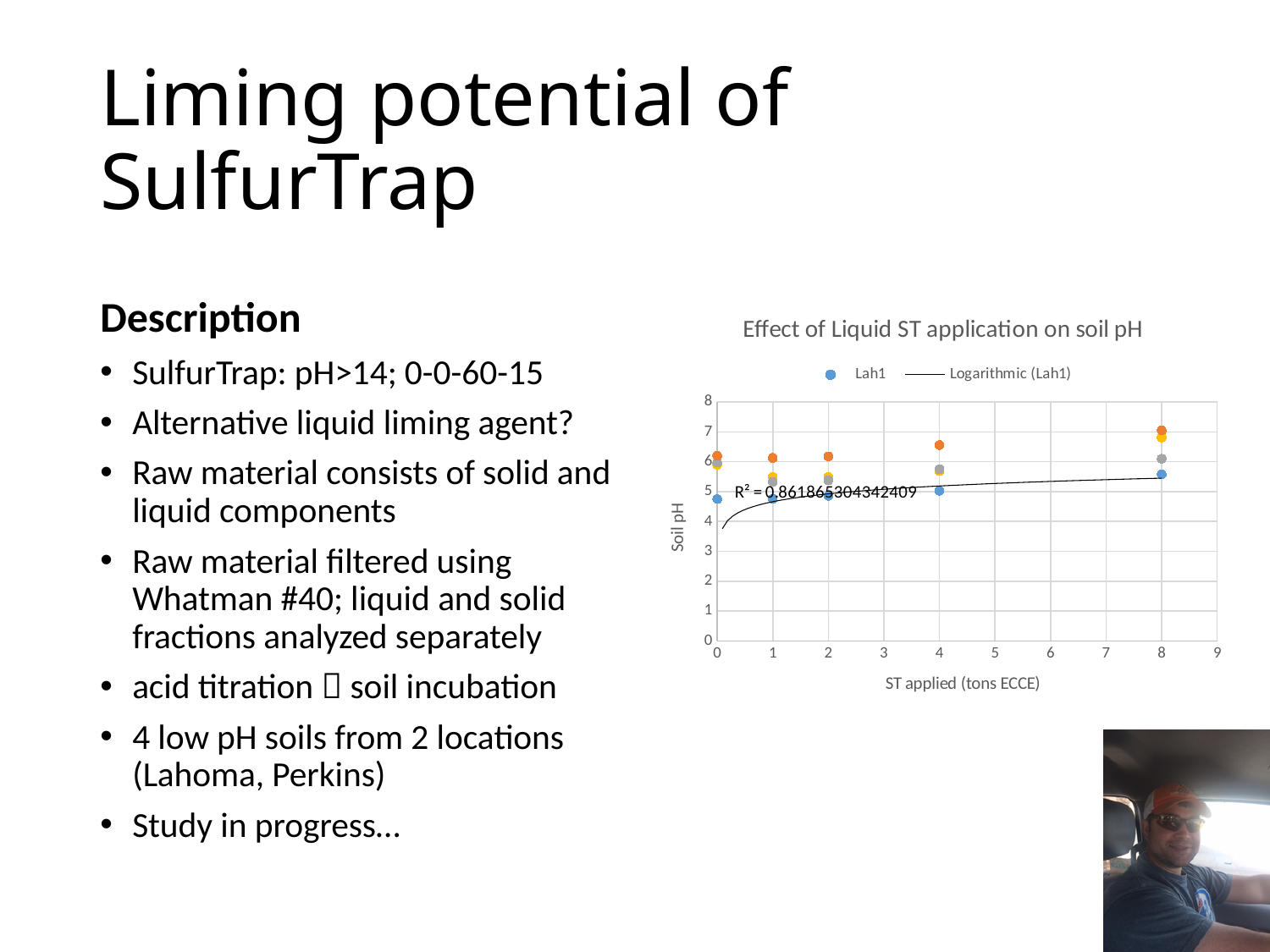
What kind of chart is shown on the slide? scatter chart What is the title of the chart? Effect of Liquid ST application on soil pH How many entries does the chart's legend list? 2 Does the Lah1 soil pH rise or fall as ST applied increases from 0 to 8 tons ECCE? rise What R² value is printed on the chart? R² = 0.8618653304342409 Which series does the logarithmic trendline in the chart fit, according to the legend? Lah1 What is the highest value shown on the y axis (Soil pH) of the chart? 8 Is the Lah1 soil pH value at 0 tons ECCE greater or less than 5? less Is the highest soil pH value plotted at 4 tons ECCE greater or less than 6? greater Is the Lah1 soil pH value at 8 tons ECCE greater or less than 5? greater What is the label of the x axis of the chart? ST applied (tons ECCE)